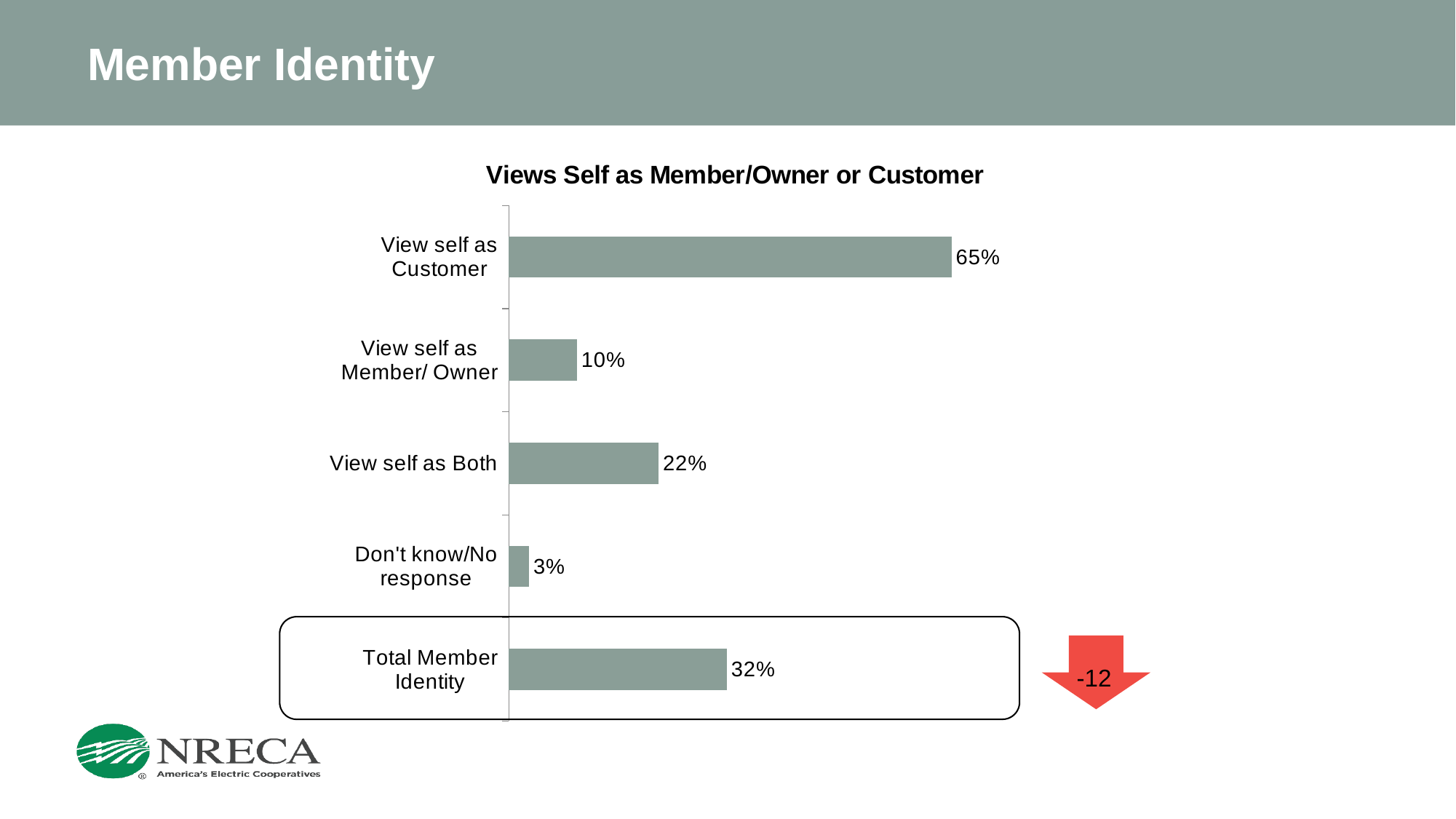
What kind of chart is shown? Bar chart What is the difference between View self as Customer and Total Member Identity? 33% What is the value for View self as Member/ Owner? 10% What is the title of the chart? Views Self as Member/Owner or Customer Which is larger, View self as Both or View self as Member/ Owner? View self as Both What is the value for View self as Both? 22% What is the value for View self as Customer? 65% Which category has the lowest value? Don't know/No response What is the value for Total Member Identity? 32% How many categories are shown in the chart? 5 What is the value for Don't know/No response? 3% Which category has the highest value? View self as Customer